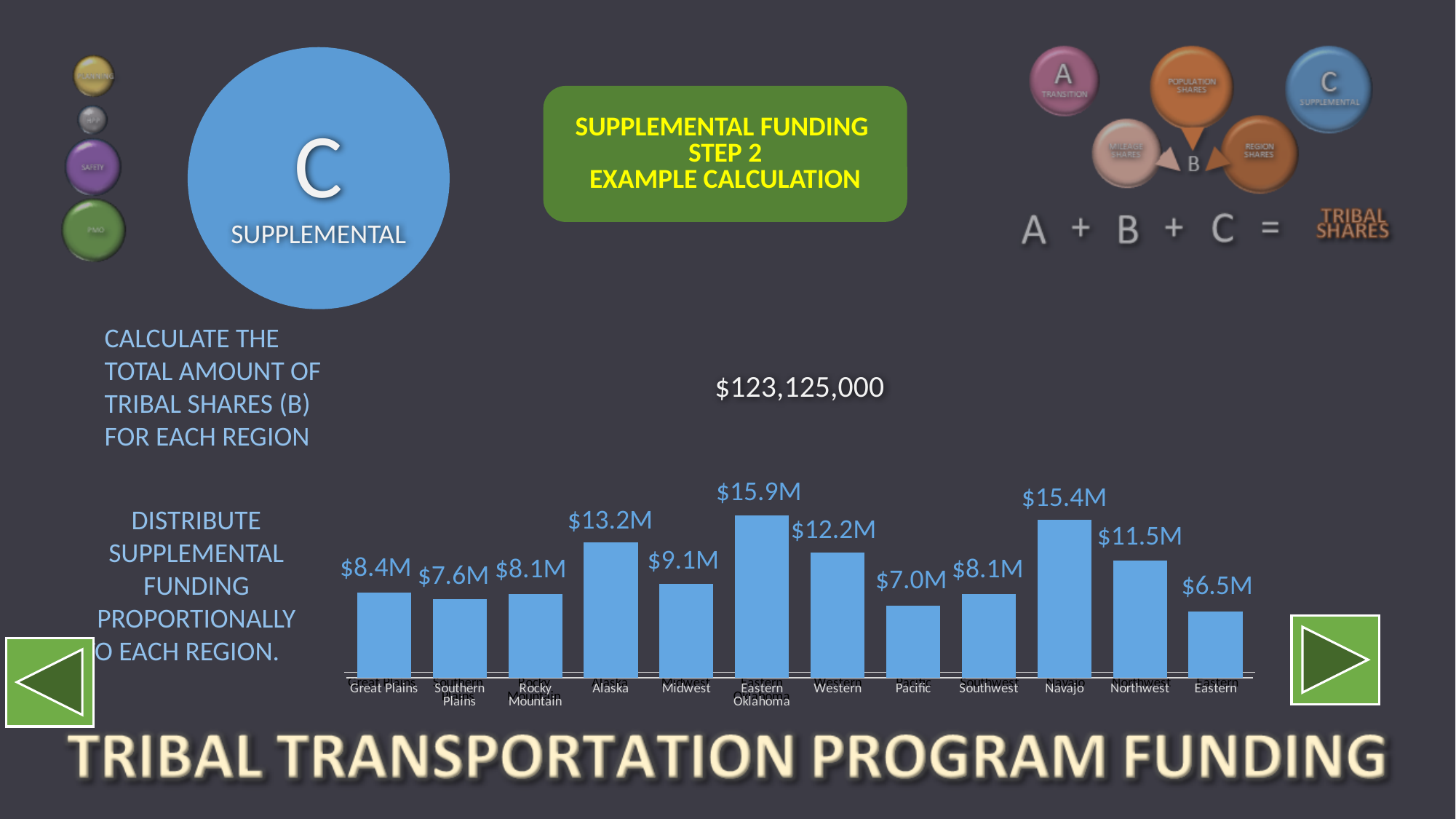
What is the difference between the values for Alaska and Western? $1.0M What kind of chart is shown? Bar chart Which is larger, the value for Midwest or the value for Southern Plains? Midwest Which region has the lowest value? Eastern What is the value for Pacific? $7.0M Which region has the highest value? Eastern Oklahoma What is the title shown above the chart? $123,125,000 What is the difference between the values for Eastern Oklahoma and Navajo? $0.5M What is the value for Navajo? $15.4M What is the value for Northwest? $11.5M What is the value for Alaska? $13.2M How many regions are shown in the chart? 12